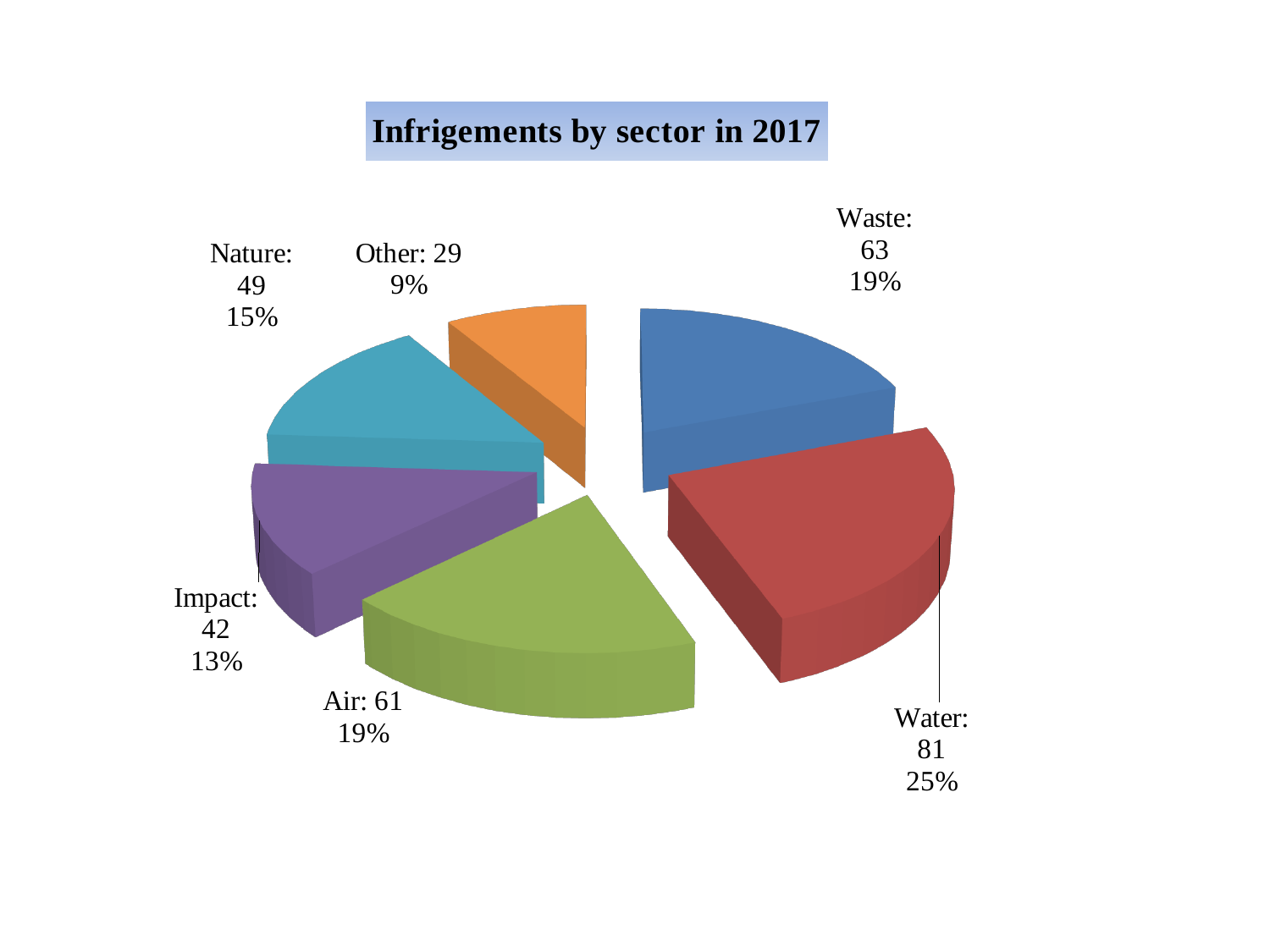
What is the title of the chart? Infrigements by sector in 2017 What is the value for Water? 81 What kind of chart is shown on the slide? Pie chart Which sector has the lowest number of infringements? Other What is the difference between the values for Water and Waste? 18 What percentage share does Other have? 9% Which sector has the highest number of infringements? Water Which is larger, the value for Air or the value for Nature? Air What is the value for Impact? 42 What percentage share does Nature have? 15% How many sectors are shown in the pie chart? 6 What colour is the Air slice? Green